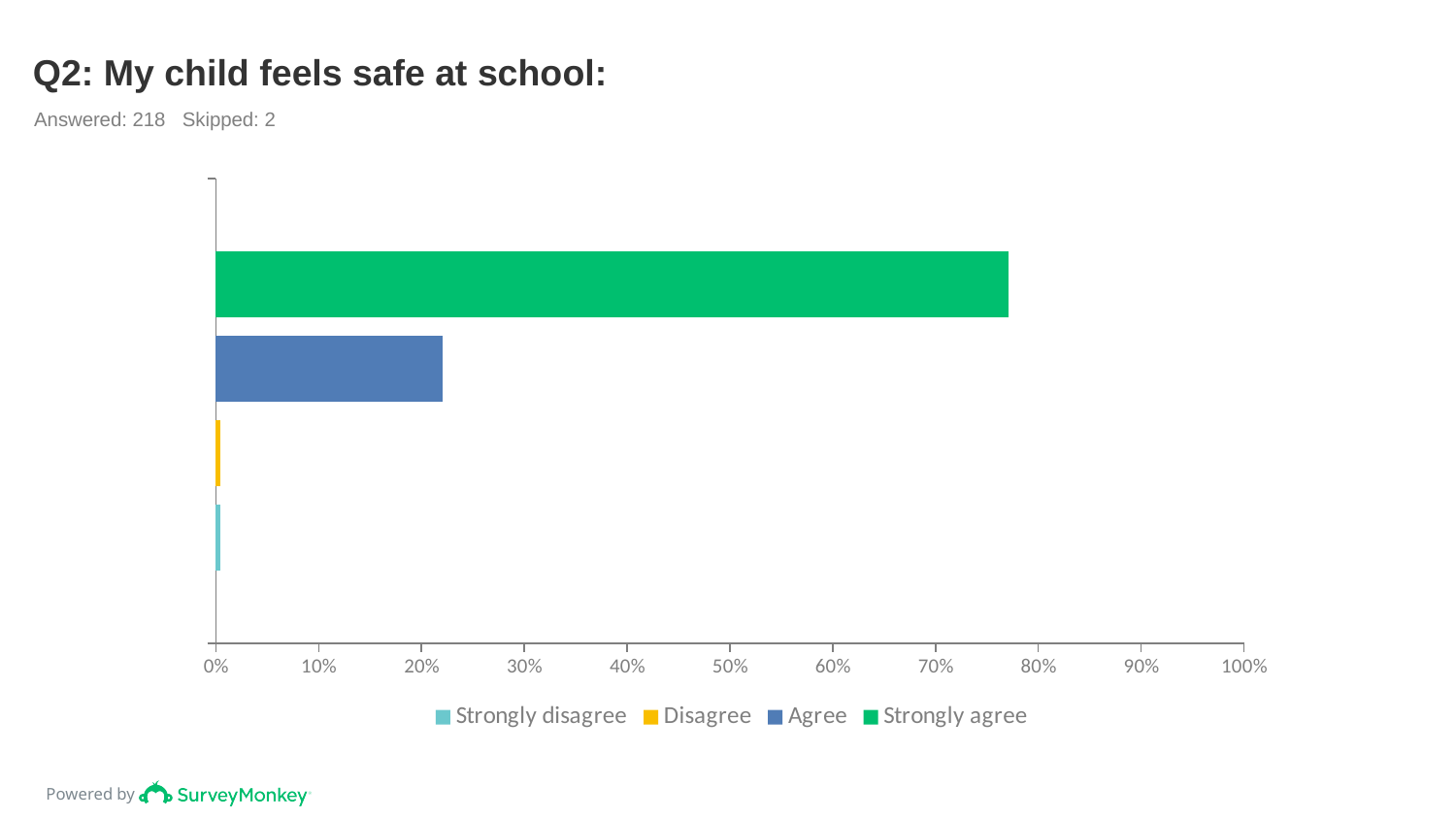
Is the value for Disagree greater or less than 10%? less Is the value for Agree greater or less than 30%? less What is the title of the chart? Q2: My child feels safe at school: How many series does the legend list? 4 Is the value for Strongly agree greater or less than 80%? less What kind of chart is shown on the slide? Bar chart Which is larger, the value for Strongly agree or the value for Agree? Strongly agree Which is larger, the value for Agree or the value for Disagree? Agree Which response category has the highest value? Strongly agree How many respondents answered the question according to the slide? 218